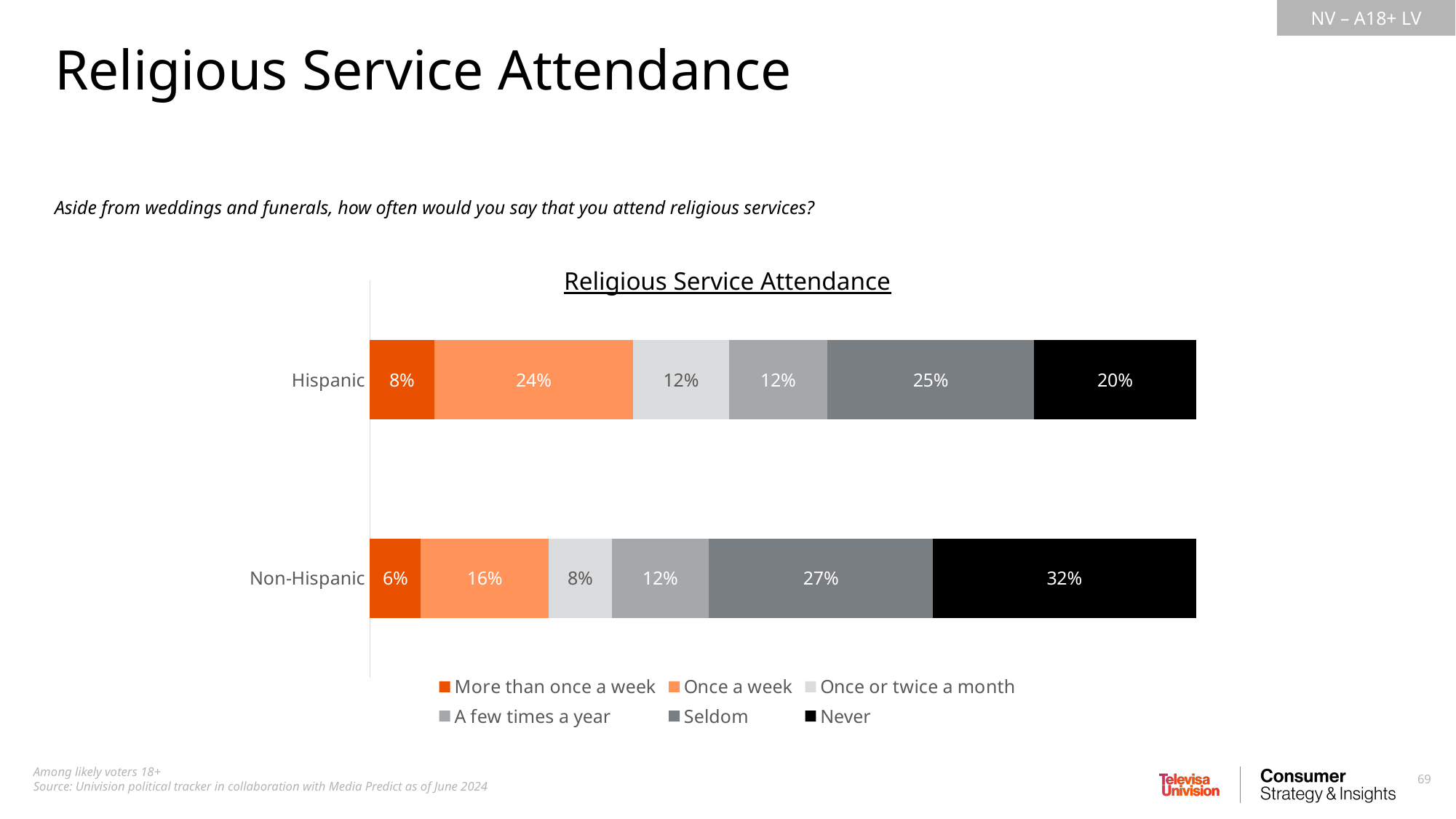
Which category has the largest share among Non-Hispanic respondents? Never Which group has a larger share for 'Once a week', Hispanic or Non-Hispanic? Hispanic Which category has the smallest share among Hispanic respondents? More than once a week What type of chart is shown on the slide? Stacked bar chart What percentage of Non-Hispanic respondents say they never attend religious services? 32% What percentage of Hispanic respondents attend religious services once a week? 24% How many series does the legend list? 6 What percentage of Non-Hispanic respondents attend religious services once or twice a month? 8% What percentage of Hispanic respondents attend religious services more than once a week? 8% How many groups (bars) are shown in the chart? 2 What is the difference between the Non-Hispanic and Hispanic shares for 'Never'? 12% What is the title of the chart? Religious Service Attendance